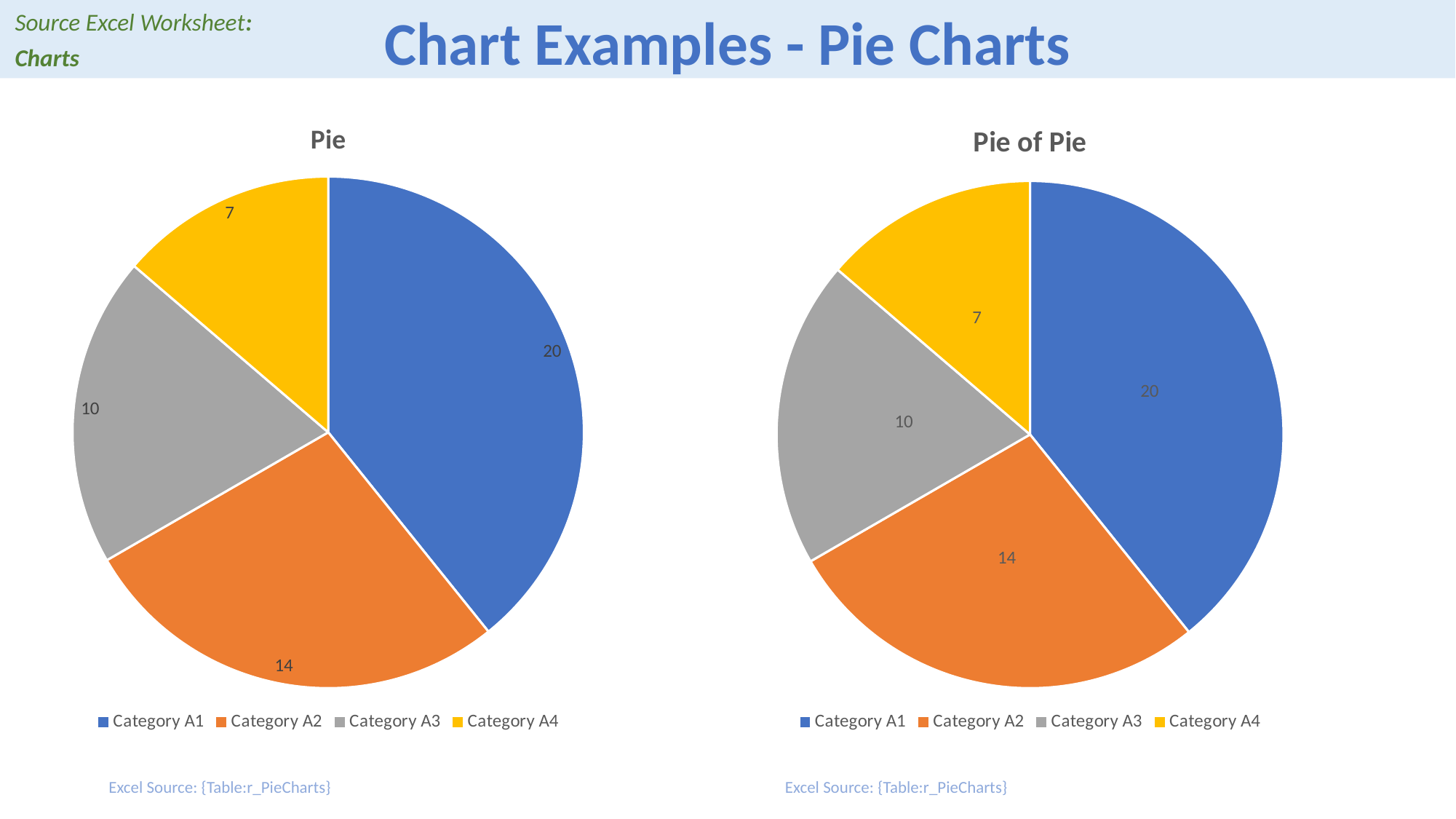
In the 'Pie' chart, what is the difference between the values for Category A1 and Category A2? 6 What is the title of the chart on the right of the slide? Pie of Pie In the 'Pie of Pie' chart, which category has the smallest slice? Category A4 In the 'Pie' chart, which category has the largest slice? Category A1 In the 'Pie of Pie' chart, what is the value for Category A4? 7 In the 'Pie' chart, which is larger, Category A2 or Category A3? Category A2 How many categories are shown in the 'Pie of Pie' chart? 4 In the 'Pie' chart, what is the value for Category A1? 20 In the 'Pie of Pie' chart, what is the difference between the values for Category A3 and Category A4? 3 In the 'Pie of Pie' chart, what is the value for Category A2? 14 In the 'Pie' chart, what is the value for Category A3? 10 What type of chart is the chart on the left of the slide? Pie chart